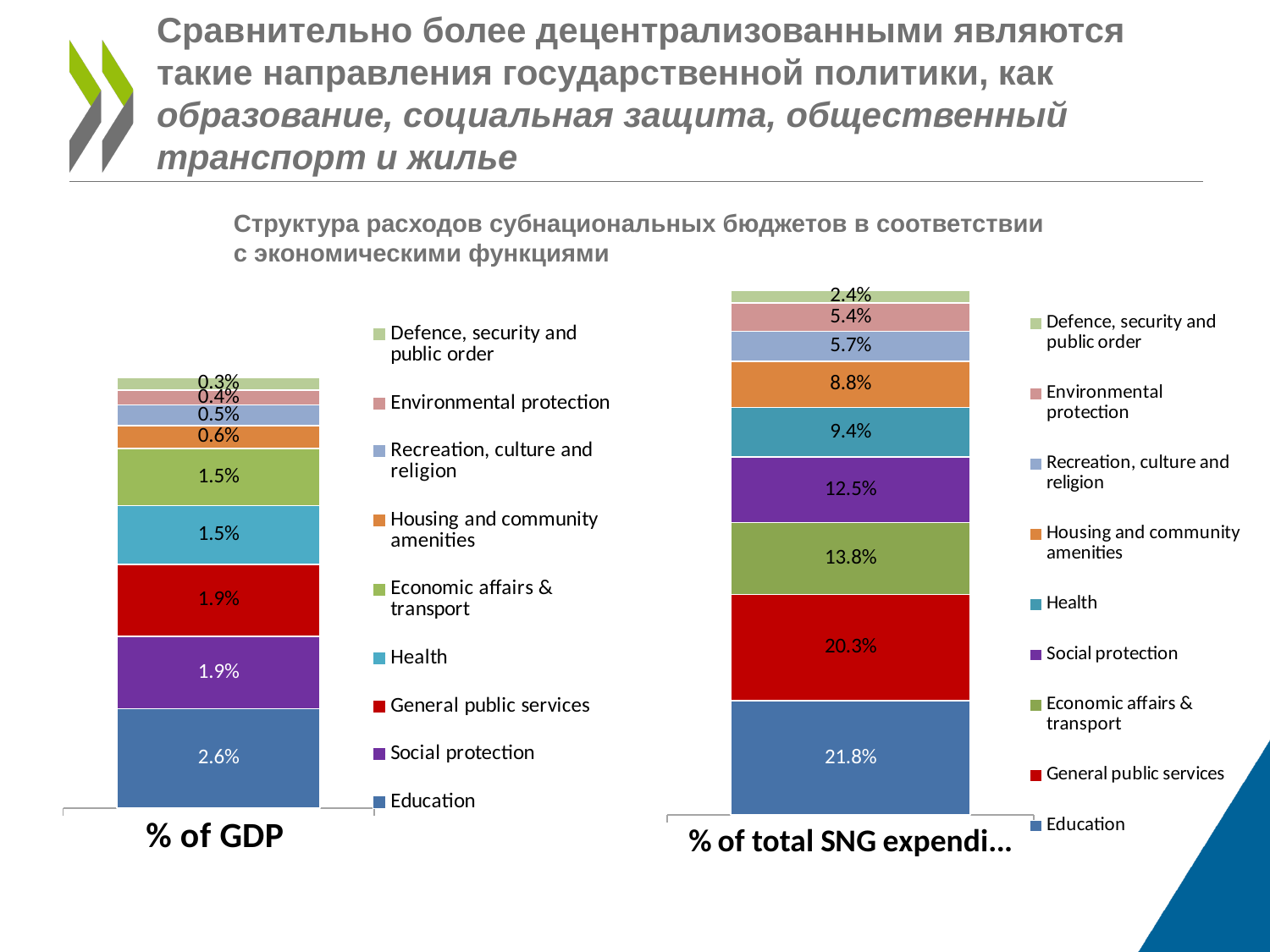
In the "% of total SNG expendi..." chart, what is the difference between Education and General public services? 1.5% In the "% of total SNG expendi..." chart, what is the value for General public services? 20.3% In the "% of total SNG expendi..." chart, which category has the largest share? Education In the "% of GDP" chart, what is the total of the stacked bar? 11.2% In the "% of total SNG expendi..." chart, what colour is the Education segment? Blue What kind of chart is the "% of total SNG expendi..." chart? Stacked bar chart In the "% of GDP" chart, what is the value for Housing and community amenities? 0.6% How many series does the legend of the "% of GDP" chart list? 9 In the "% of GDP" chart, which category has the smallest value? Defence, security and public order In the "% of GDP" chart, what is the value for Education? 2.6% In the "% of total SNG expendi..." chart, what is the value for Health? 9.4% In the "% of total SNG expendi..." chart, which is larger: Economic affairs & transport or Social protection? Economic affairs & transport